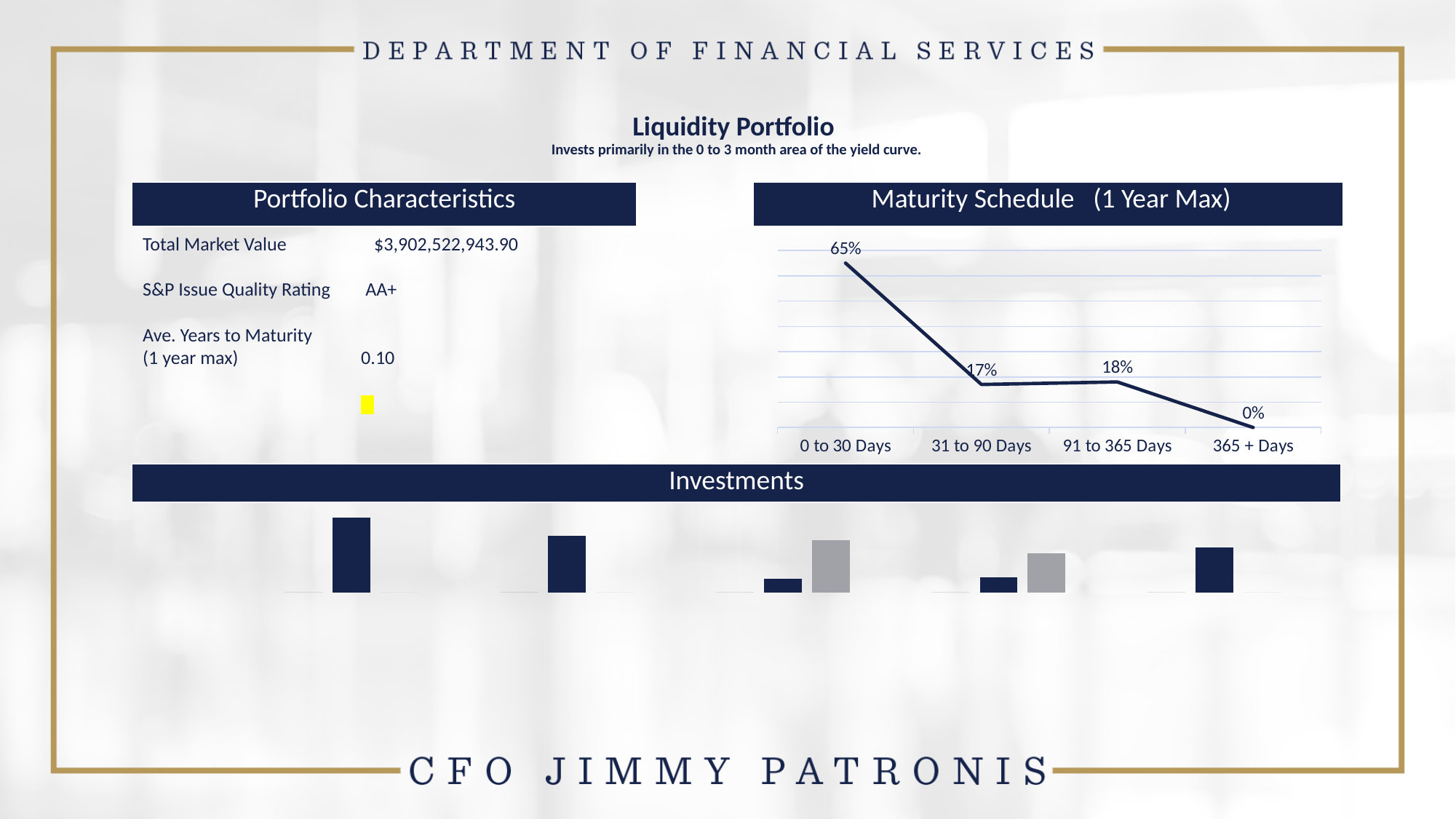
In the Maturity Schedule (1 Year Max) chart, what is the value for 91 to 365 Days? 18% What is the title of the line chart on the right side of the slide? Maturity Schedule (1 Year Max) In the Maturity Schedule (1 Year Max) chart, which is larger: the value for 31 to 90 Days or the value for 91 to 365 Days? 91 to 365 Days In the Maturity Schedule (1 Year Max) chart, what is the value for 0 to 30 Days? 65% In the Maturity Schedule (1 Year Max) chart, which maturity bucket has the highest value? 0 to 30 Days What kind of chart is the Maturity Schedule (1 Year Max) chart? Line chart In the Maturity Schedule (1 Year Max) chart, do the values generally rise or fall from 0 to 30 Days to 365 + Days? Fall In the Maturity Schedule (1 Year Max) chart, what is the value for 31 to 90 Days? 17% In the Maturity Schedule (1 Year Max) chart, what is the difference between the values for 0 to 30 Days and 31 to 90 Days? 48% In the Maturity Schedule (1 Year Max) chart, which maturity bucket has the lowest value? 365 + Days In the Maturity Schedule (1 Year Max) chart, what is the value for 365 + Days? 0% How many maturity buckets are shown on the x axis of the Maturity Schedule (1 Year Max) chart? 4